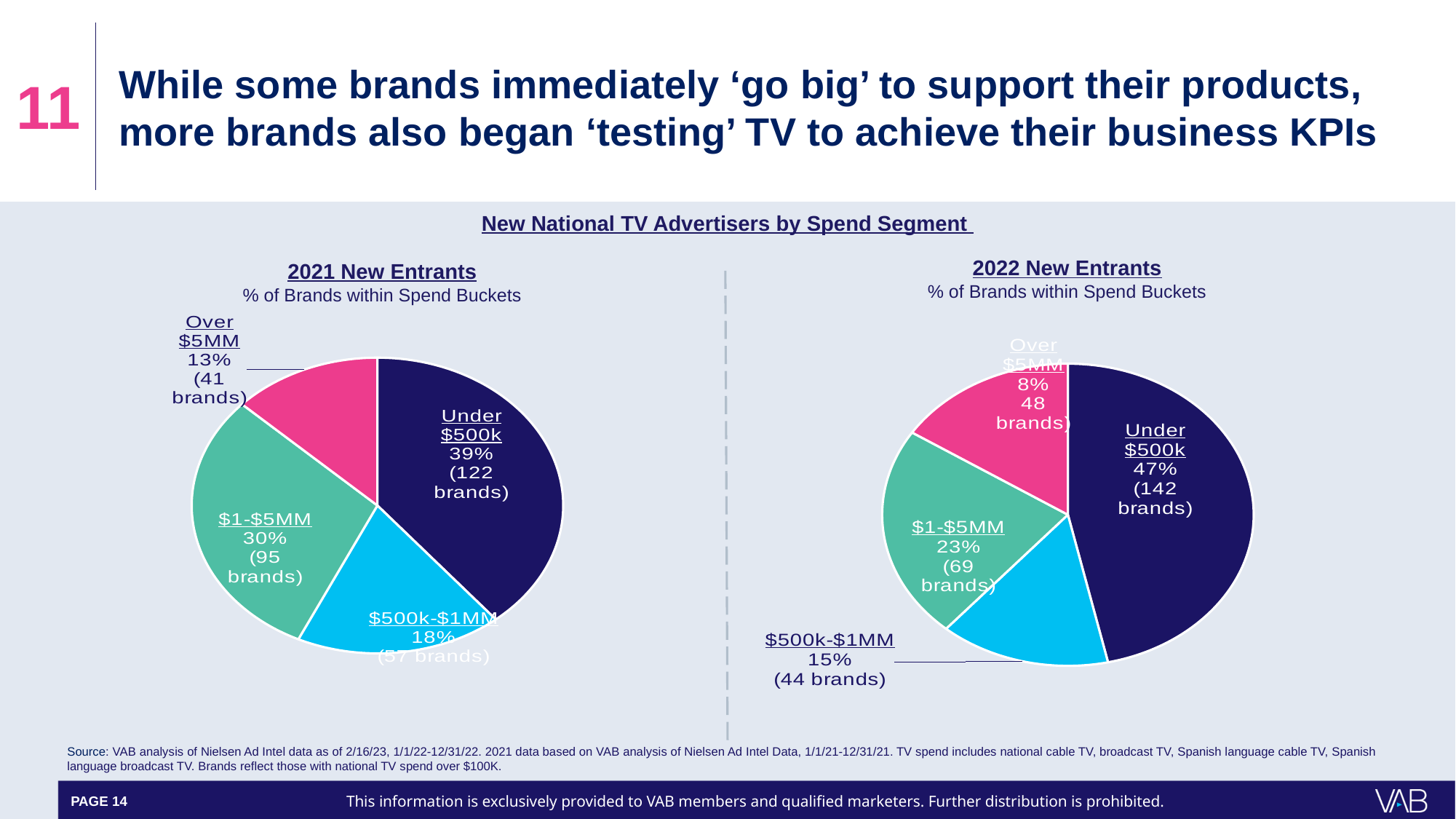
In the 2022 New Entrants chart, what share of brands is in the Under $500k spend bucket? 47% In the 2022 New Entrants chart, which spend bucket has the largest share of brands? Under $500k What is the overall title above the two charts? New National TV Advertisers by Spend Segment In the 2021 New Entrants chart, which bucket has a larger share: $500k-$1MM or $1-$5MM? $1-$5MM In the 2021 New Entrants chart, what share of brands is in the Under $500k spend bucket? 39% In the 2022 New Entrants chart, how many brands are in the $500k-$1MM spend bucket? 44 brands In the 2021 New Entrants chart, how many brands are in the $1-$5MM spend bucket? 95 brands How many spend segments does the 2021 New Entrants chart show? 4 What kind of chart is used for the 2022 New Entrants? Pie chart In the 2021 New Entrants chart, which spend bucket has the smallest share of brands? Over $5MM In the 2022 New Entrants chart, what is the difference in percentage points between the Under $500k and $1-$5MM buckets? 24 percentage points